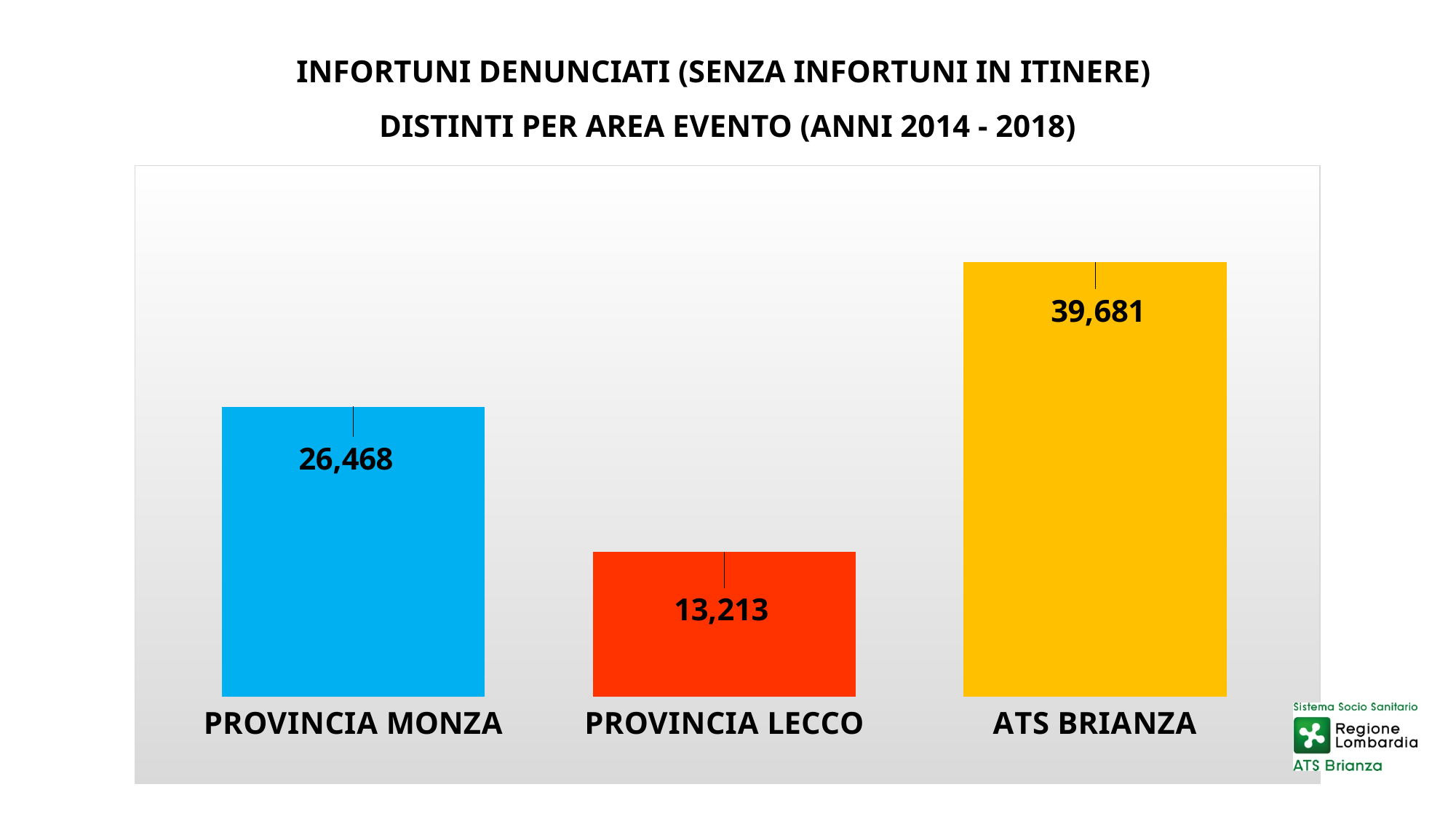
How many categories are shown in the chart? 3 Which category has the highest value? ATS BRIANZA Which category has the lowest value? PROVINCIA LECCO What is the difference between the values for PROVINCIA MONZA and PROVINCIA LECCO? 13,255 What is the title of the chart? INFORTUNI DENUNCIATI (SENZA INFORTUNI IN ITINERE) DISTINTI PER AREA EVENTO (ANNI 2014 - 2018) Which is larger, the value for PROVINCIA MONZA or the value for PROVINCIA LECCO? PROVINCIA MONZA What is the difference between the values for ATS BRIANZA and PROVINCIA MONZA? 13,213 What is the value for PROVINCIA LECCO? 13,213 What colour is the bar for ATS BRIANZA? Yellow What is the value for PROVINCIA MONZA? 26,468 What kind of chart is shown on the slide? Bar chart What is the value for ATS BRIANZA? 39,681